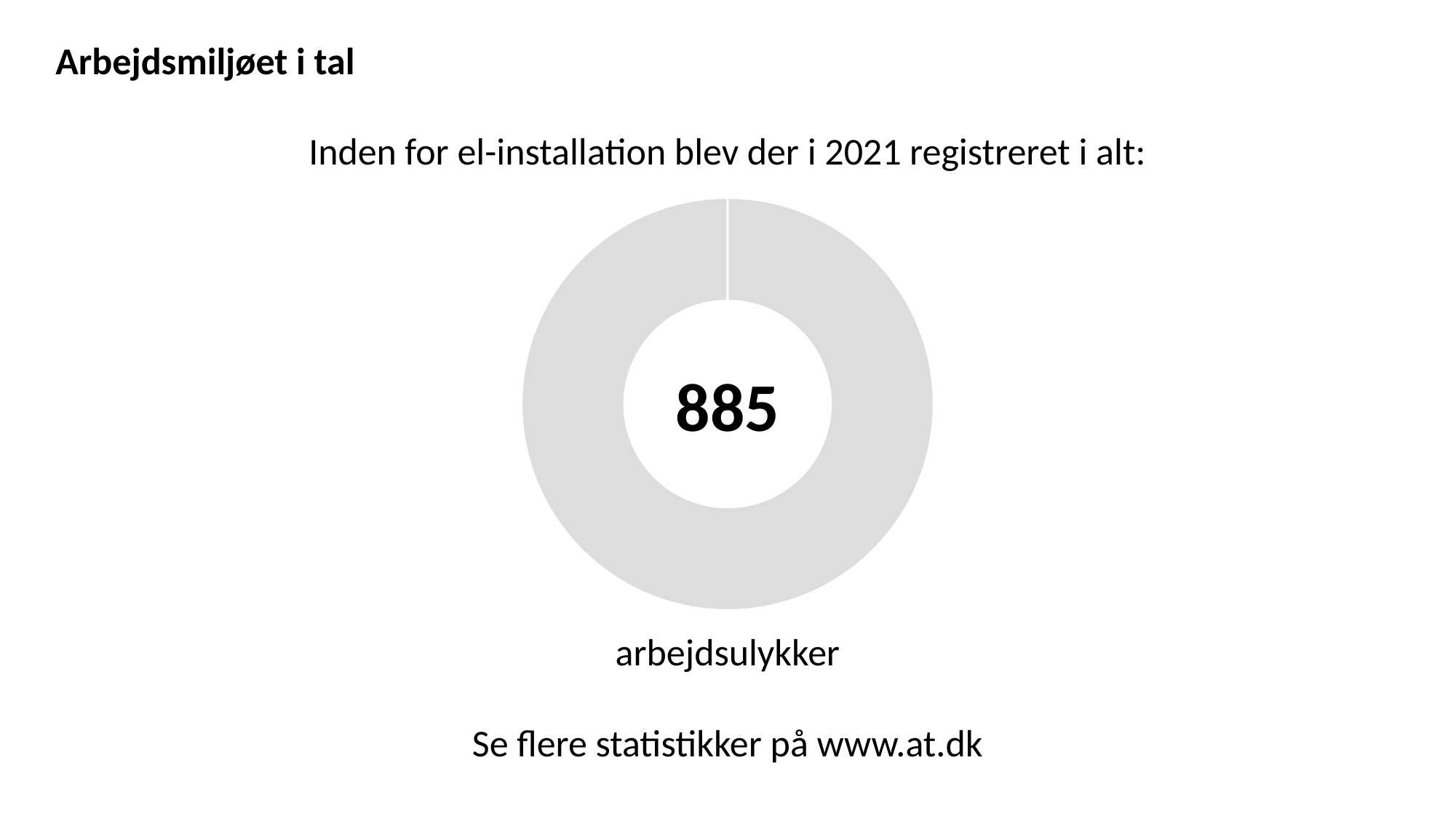
What does the value 885 in the chart represent, according to the label below it? arbejdsulykker How many arbejdsulykker were registered within el-installation in 2021 according to the chart? 885 Is the value shown in the doughnut chart greater or less than 1000? less Is the value shown in the doughnut chart greater or less than 800? greater How many distinct values does the doughnut chart display? 1 What kind of chart is shown on the slide? doughnut chart What number is displayed in the centre of the doughnut chart? 885 Which year does the chart's figure refer to? 2021